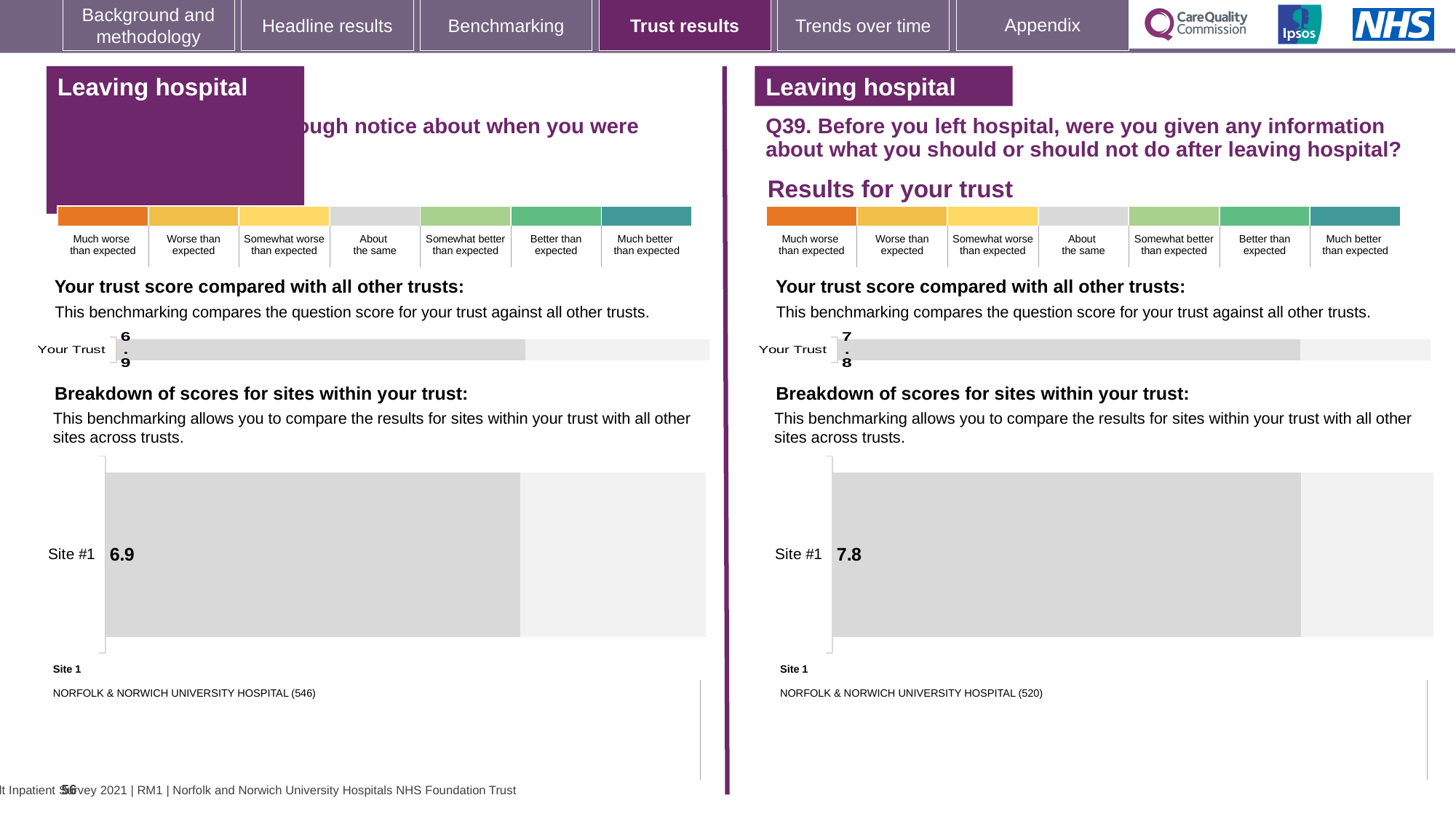
On the right-hand (Q39) 'Your trust score compared with all other trusts' chart, what is the value for Your Trust? 7.8 How many sites are shown on the right-hand (Q39) 'Breakdown of scores for sites within your trust' chart? 1 On the right-hand (Q39) breakdown chart, what is the name of Site 1 given below the chart? NORFOLK & NORWICH UNIVERSITY HOSPITAL (520) What is the difference between the Your Trust score on the right-hand (Q39) chart and the Your Trust score on the left-hand chart? 0.9 On the left-hand 'Breakdown of scores for sites within your trust' chart, what is the score for Site #1? 6.9 On the left-hand breakdown chart, what is the name of Site 1 given below the chart? NORFOLK & NORWICH UNIVERSITY HOSPITAL (546) What kind of chart is the 'Breakdown of scores for sites within your trust' chart on the right-hand (Q39) side? Bar chart Which is larger: the Site #1 score on the left-hand breakdown chart or the Site #1 score on the right-hand (Q39) breakdown chart? The right-hand (Q39) chart How many sites are shown on the left-hand 'Breakdown of scores for sites within your trust' chart? 1 On the right-hand (Q39) 'Breakdown of scores for sites within your trust' chart, what is the score for Site #1? 7.8 On the left-hand 'Your trust score compared with all other trusts' chart, what is the value for Your Trust? 6.9 On the right-hand (Q39) side, is the Your Trust score equal to the Site #1 score? Yes